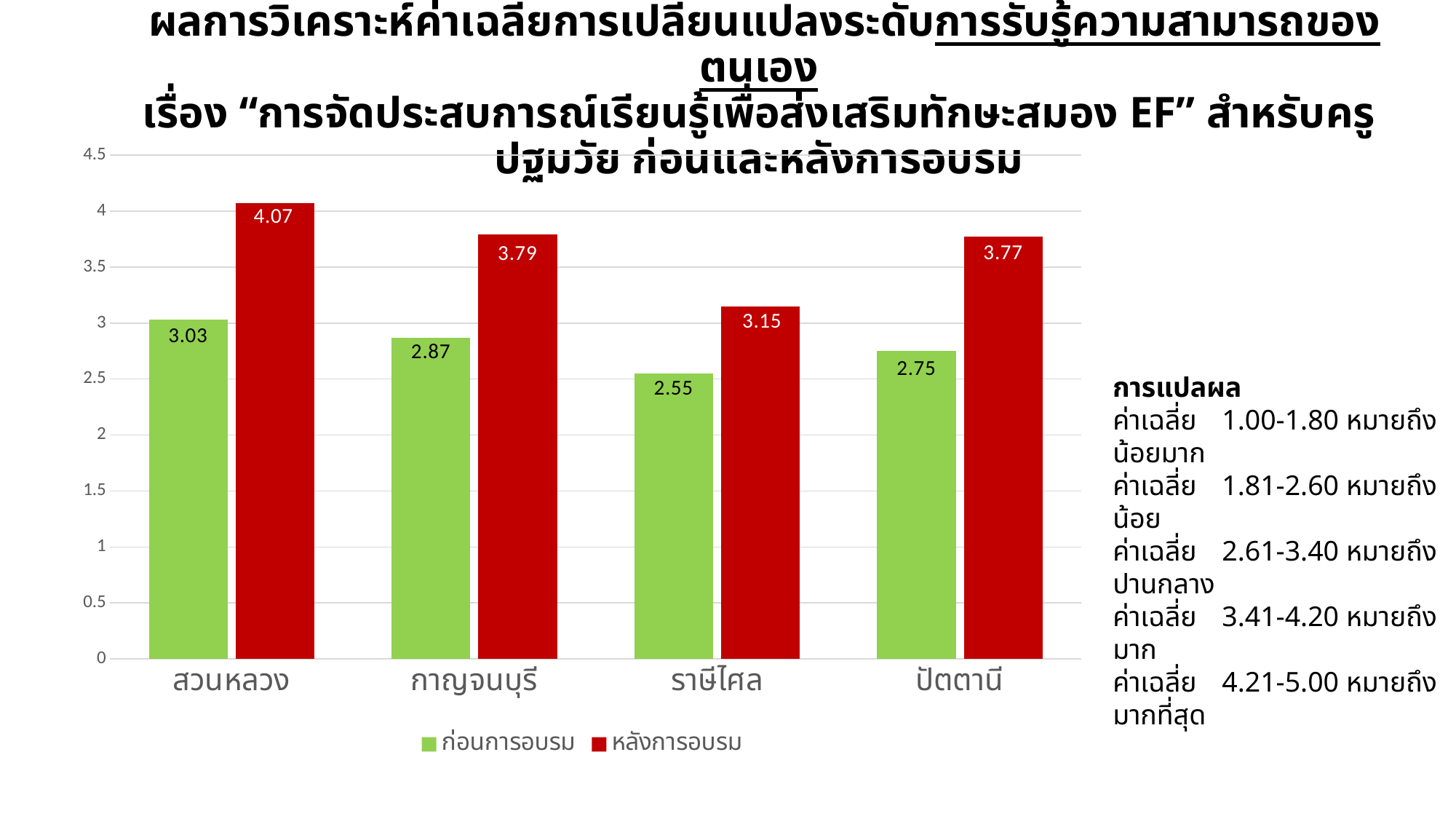
Which category has the lowest value for ก่อนการอบรม? ราษีไศล Which is larger at ปัตตานี: the ก่อนการอบรม value or the หลังการอบรม value? หลังการอบรม What is the value for ก่อนการอบรม at ปัตตานี? 2.75 Which category has the highest value for หลังการอบรม? สวนหลวง How many categories are shown on the x axis? 4 What is the value for หลังการอบรม at ราษีไศล? 3.15 What kind of chart is shown on the slide? bar chart What is the value for ก่อนการอบรม at สวนหลวง? 3.03 What is the difference between the หลังการอบรม and ก่อนการอบรม values at กาญจนบุรี? 0.92 How many series does the legend list? 2 What colour are the bars for หลังการอบรม? red Is the value for หลังการอบรม at สวนหลวง greater or less than 4? greater